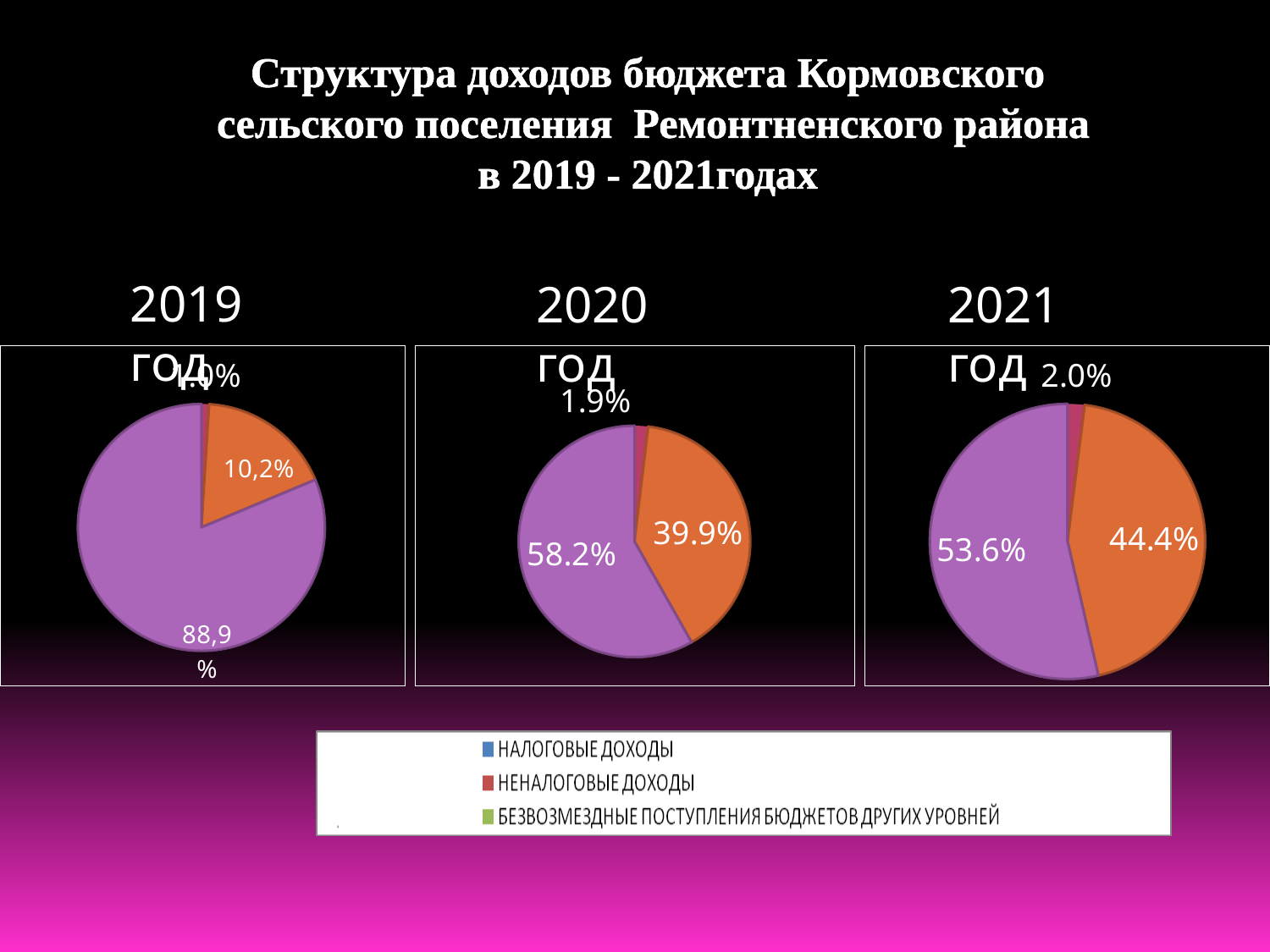
Is the orange slice larger in the 2020 ГОД chart or in the 2021 ГОД chart? 2021 ГОД What type of charts are shown on the slide? Pie charts In the 2020 ГОД pie chart, what is the value of the smallest slice? 1.9% In the 2021 ГОД pie chart, what is the value of the orange slice? 44.4% In the 2020 ГОД pie chart, what is the value of the largest slice? 58.2% In the 2021 ГОД pie chart, what is the value of the smallest slice? 2.0% In the 2019 ГОД pie chart, what is the value of the largest slice? 88,9% How many entries does the legend list? 3 Does the share of the purple slice rise or fall from the 2019 chart to the 2021 chart? Fall In the 2020 ГОД pie chart, what is the difference between the purple slice (58.2%) and the orange slice (39.9%)? 18.3% In the 2019 ГОД pie chart, what is the value of the orange slice? 10,2% How many pie charts are on the slide? 3